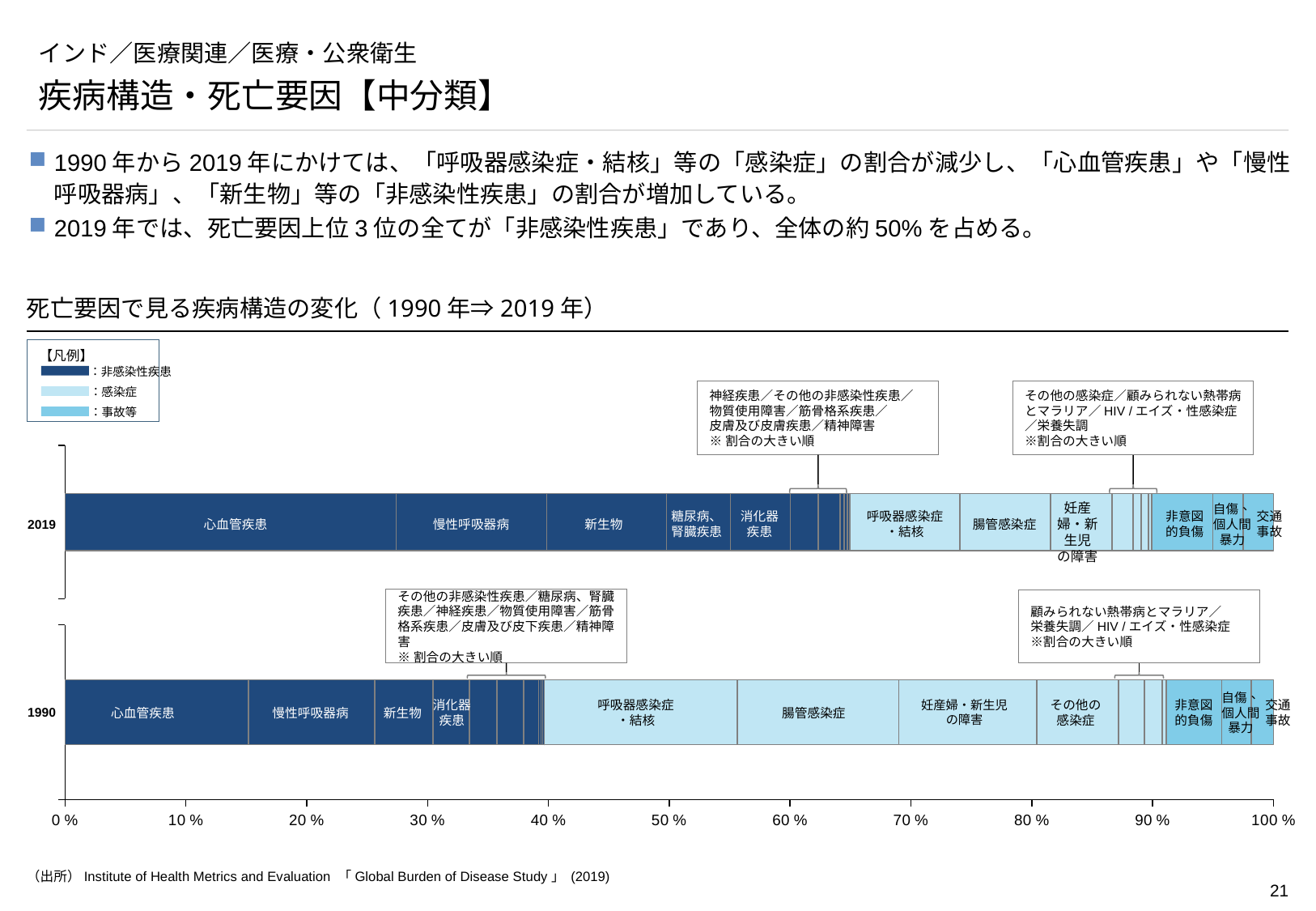
How many bars (years) are plotted in the chart? 2 Which years are compared in the chart? 1990 and 2019 Which year has the larger share of 呼吸器感染症・結核, 1990 or 2019? 1990 Is the share of 心血管疾患 in 1990 greater or less than 20%? less Which legend category is shown in dark blue? 非感染性疾患 What kind of chart is shown on the slide? Stacked bar chart How many series does the legend list? 3 In the 2019 bar, which cause of death has the largest share? 心血管疾患 Is the share of 心血管疾患 in 2019 greater or less than 20%? greater Which year has the larger share of 新生物, 1990 or 2019? 2019 Which year has the larger share of 心血管疾患, 1990 or 2019? 2019 Is the share of 呼吸器感染症・結核 in 1990 greater or less than 10%? greater